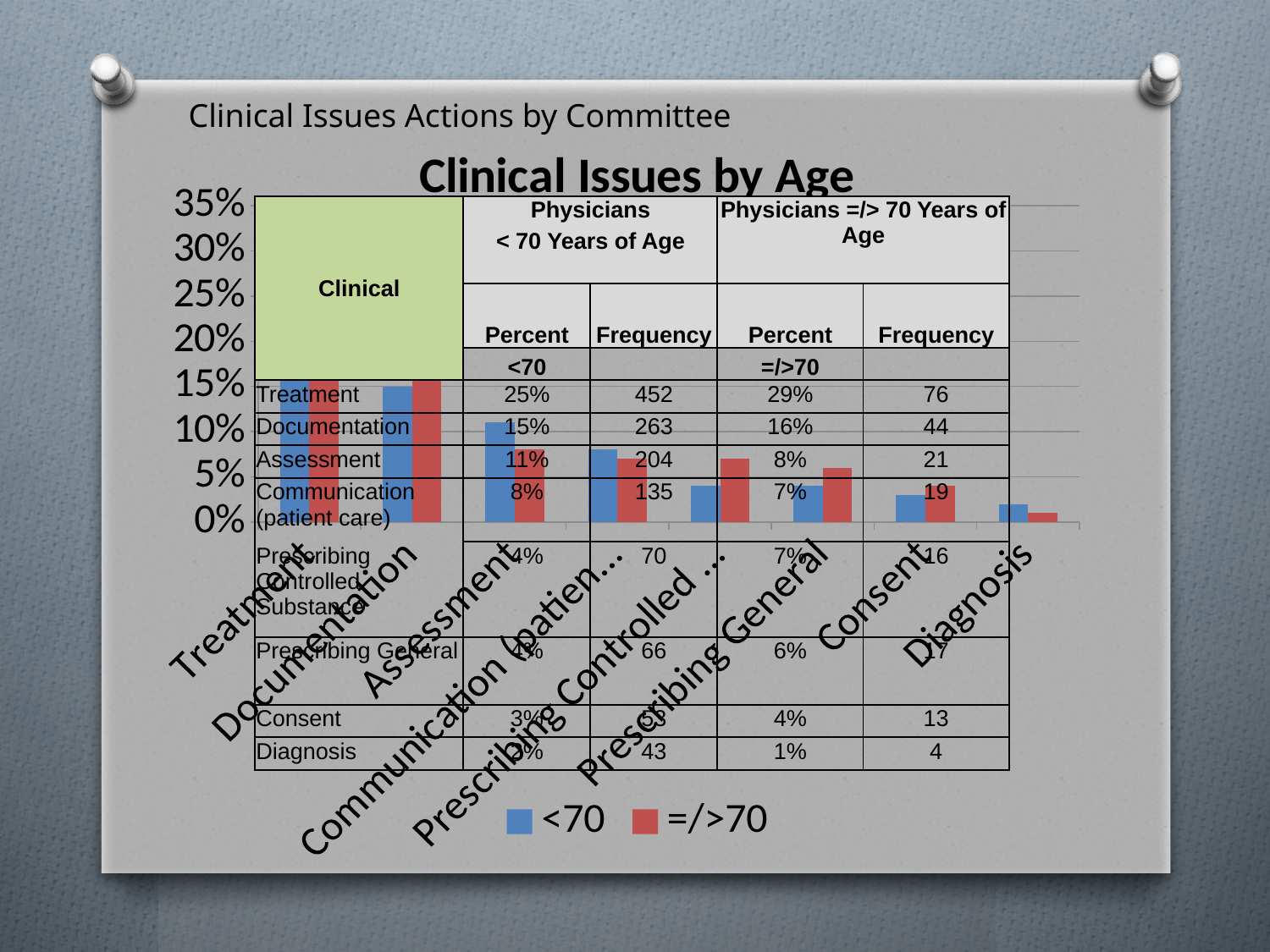
Is the <70 value for Treatment greater or less than 20%? greater According to the table on the chart, what is the percent for Treatment among physicians =/>70 years of age? 29% Do the values generally rise or fall moving from left to right along the x axis? fall Which category has the lowest value for the =/>70 series? Diagnosis According to the table on the chart, what is the percent for Documentation among physicians <70 years of age? 15% Which category has the highest value for the <70 series? Treatment How many clinical issue categories are plotted along the x axis? 8 For Assessment, which series has the larger value, <70 or =/>70? <70 What is the title of the chart? Clinical Issues by Age What kind of chart is shown on the slide? bar chart How many series does the chart legend list? 2 What is the difference between the =/>70 and <70 percent values for Treatment? 4%